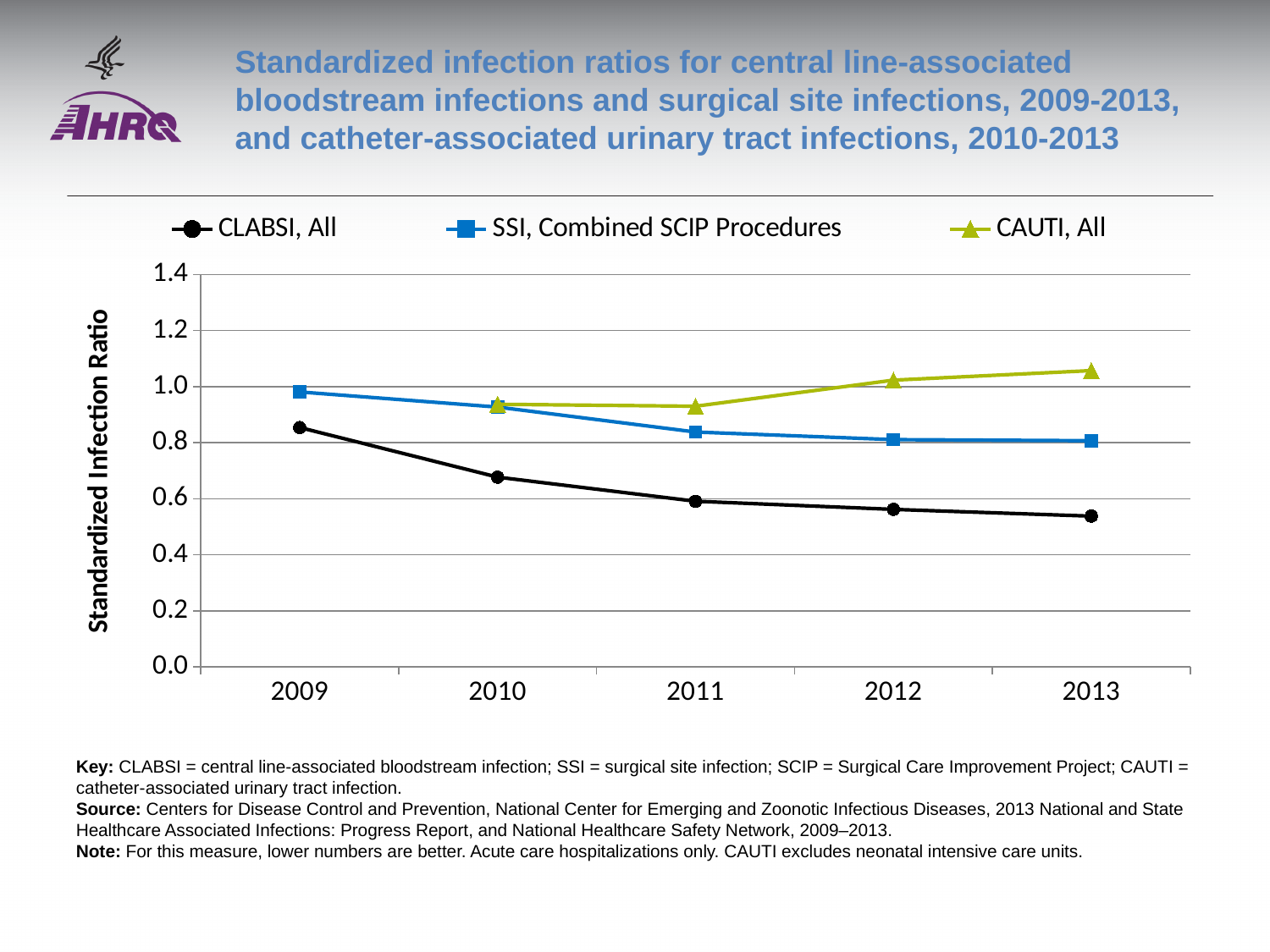
What kind of chart is shown on the slide? line chart Does the CAUTI, All series rise or fall from 2010 to 2013? rise Does the CLABSI, All series rise or fall from 2009 to 2013? fall How many years are shown on the x axis? 5 In 2009, which is larger: the value for CLABSI, All or the value for SSI, Combined SCIP Procedures? SSI, Combined SCIP Procedures Is the value for CLABSI, All in 2009 greater or less than 0.8? greater Which series has the lowest value in 2013? CLABSI, All Which series has the highest value in 2013? CAUTI, All Is the value for CAUTI, All in 2013 greater or less than 1.0? greater How many series does the legend list? 3 Is the value for CLABSI, All in 2010 greater or less than 0.6? greater